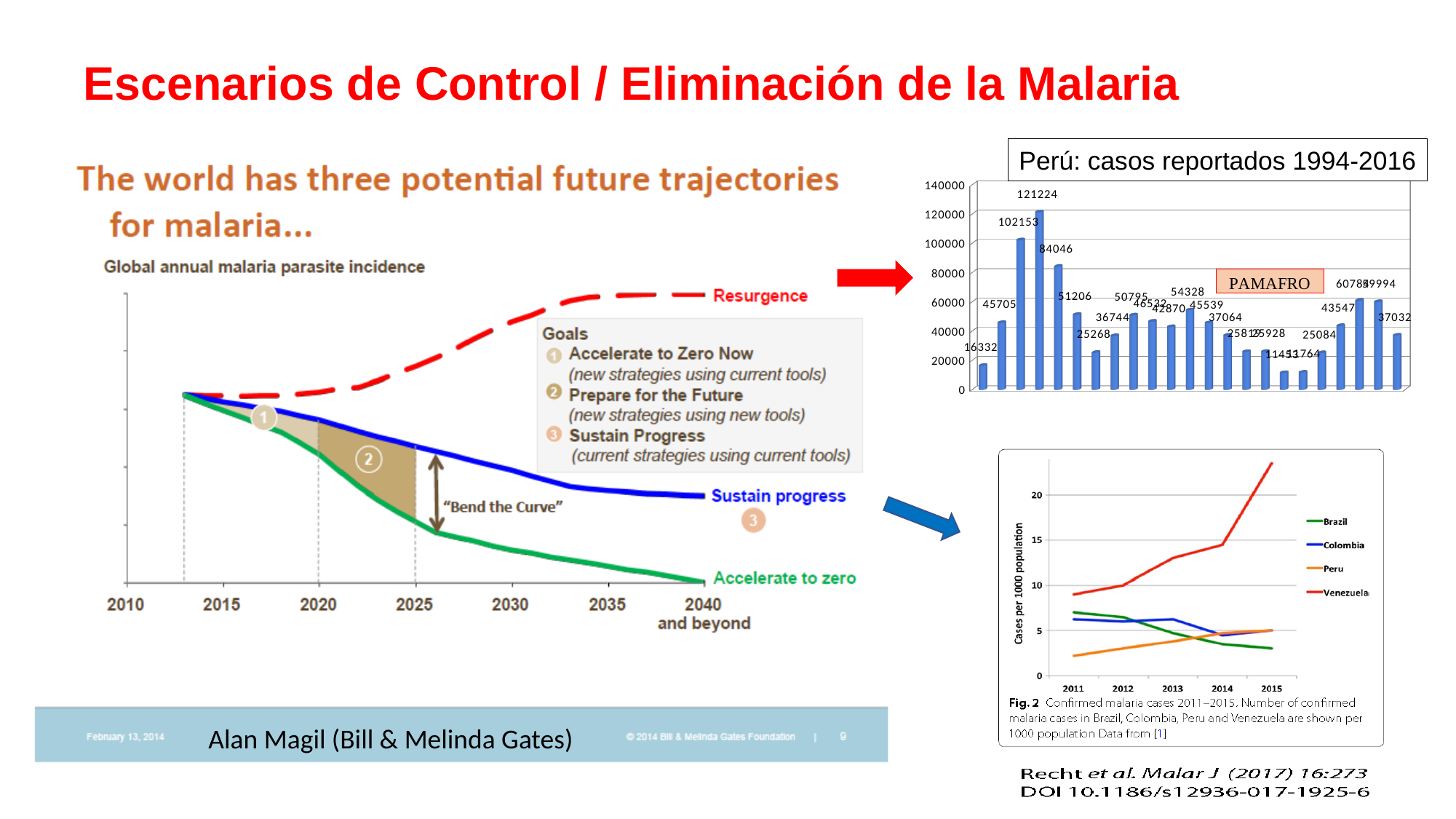
In the left chart 'Global annual malaria parasite incidence', which trajectory is highest at 2040? Resurgence In the bottom-right line chart (Fig. 2), does the Venezuela line rise or fall from 2011 to 2015? rise In the bar chart titled 'Perú: casos reportados 1994-2016', what is the maximum value shown on the vertical axis? 140000 In the bottom-right line chart (Fig. 2), which is larger in 2011: the value for Brazil or the value for Peru? Brazil In the bar chart titled 'Perú: casos reportados 1994-2016', what is the value of the first bar? 16332 In the bar chart titled 'Perú: casos reportados 1994-2016', what is the highest value shown? 121224 In the bottom-right line chart (Fig. 2, cases per 1000 population), how many countries does the legend list? 4 In the bar chart titled 'Perú: casos reportados 1994-2016', what is the value of the last bar? 37032 In the bottom-right line chart (Fig. 2), is the value for Venezuela in 2015 greater or less than 20? greater In the bottom-right line chart (Fig. 2), which country has the highest value in 2015? Venezuela What kind of chart is the one titled 'Perú: casos reportados 1994-2016'? bar chart In the bar chart titled 'Perú: casos reportados 1994-2016', what is the difference between the highest bar (121224) and the bar labelled 102153? 19071